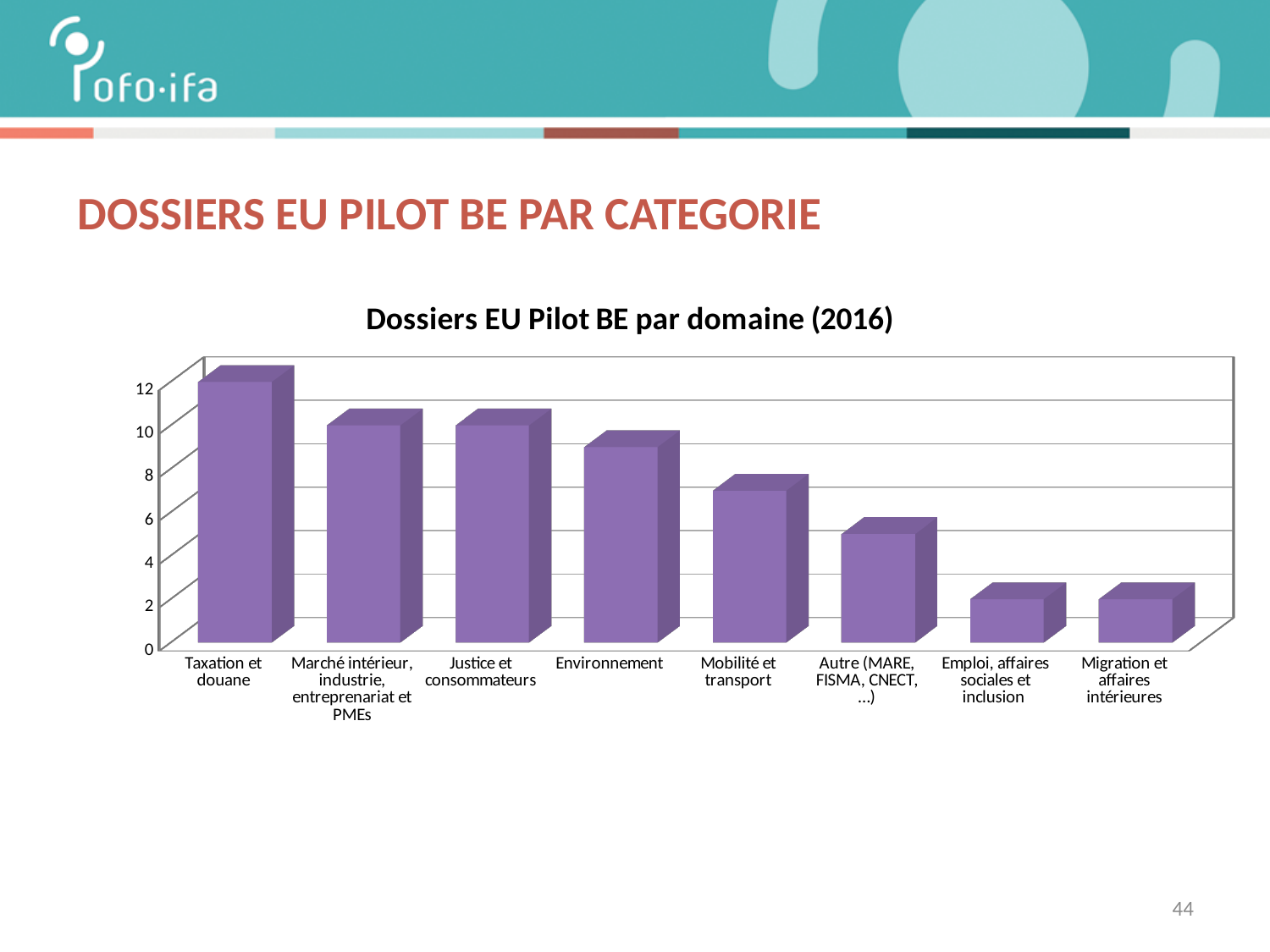
What is the value for Justice et consommateurs? 10 Is the value for Mobilité et transport greater or less than 8? less Which is larger, the value for Environnement or the value for Mobilité et transport? Environnement Do the values rise or fall from left to right along the x axis? fall Which category has the highest value in the chart? Taxation et douane What is the title of the chart? Dossiers EU Pilot BE par domaine (2016) Is the value for Environnement greater or less than 8? greater What kind of chart is shown on the slide? bar chart What is the value for Taxation et douane? 12 What is the value for Emploi, affaires sociales et inclusion? 2 How many categories are shown on the x axis of the chart? 8 Is the value for Autre (MARE, FISMA, CNECT, …) greater or less than 4? greater